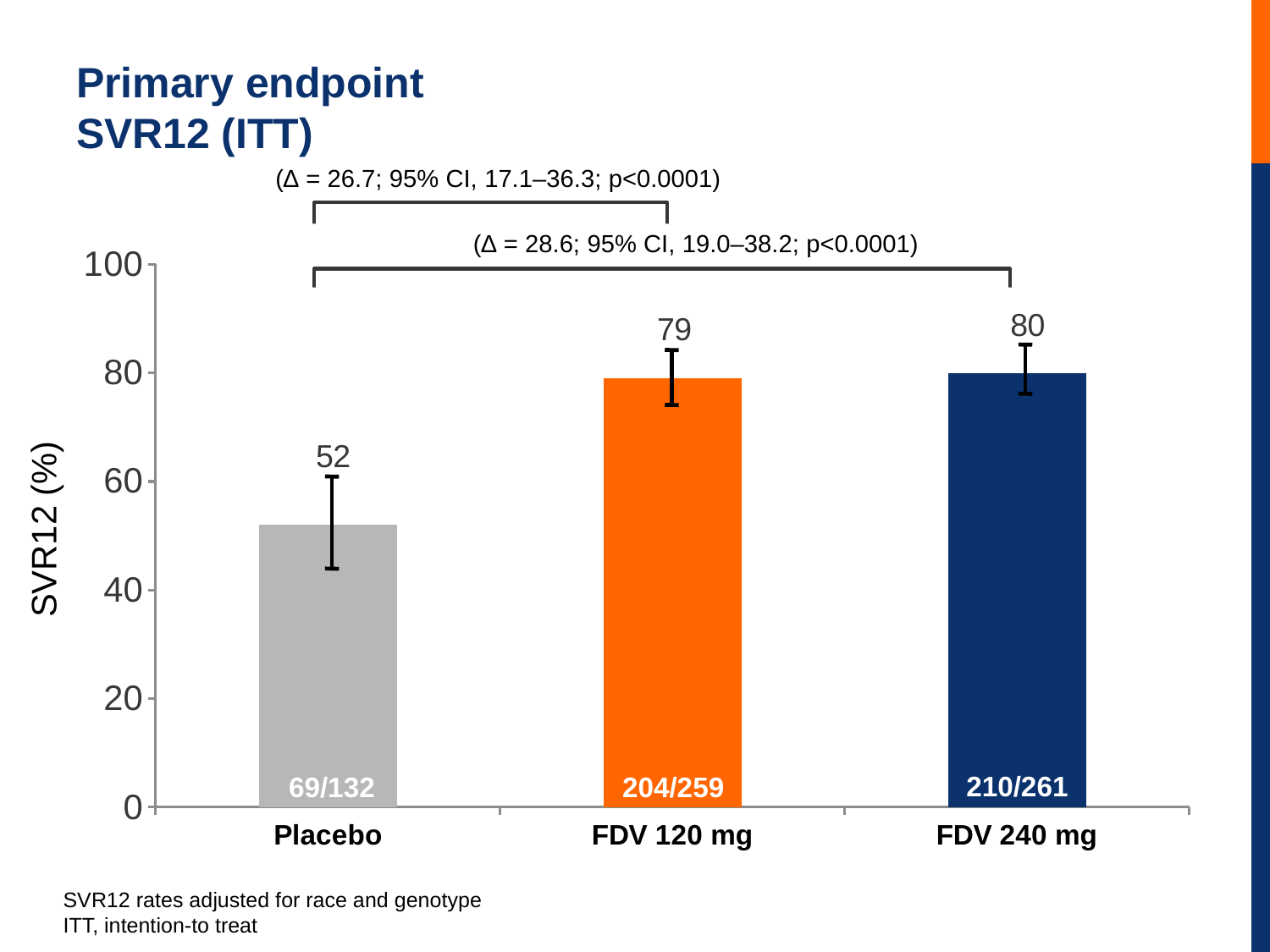
What is the difference in SVR12 between FDV 240 mg and Placebo? 28 Is the SVR12 value for Placebo greater or less than 60? less Which group has the lowest SVR12 value? Placebo What is the difference in SVR12 between FDV 120 mg and Placebo? 27 What is the SVR12 value for FDV 240 mg? 80 What fraction is printed inside the FDV 240 mg bar? 210/261 What kind of chart is shown on the slide? bar chart What is the SVR12 value for Placebo? 52 What is the label of the y axis? SVR12 (%) How many treatment groups are shown in the chart? 3 Which is larger, the SVR12 value for Placebo or for FDV 120 mg? FDV 120 mg What is the SVR12 value for FDV 120 mg? 79